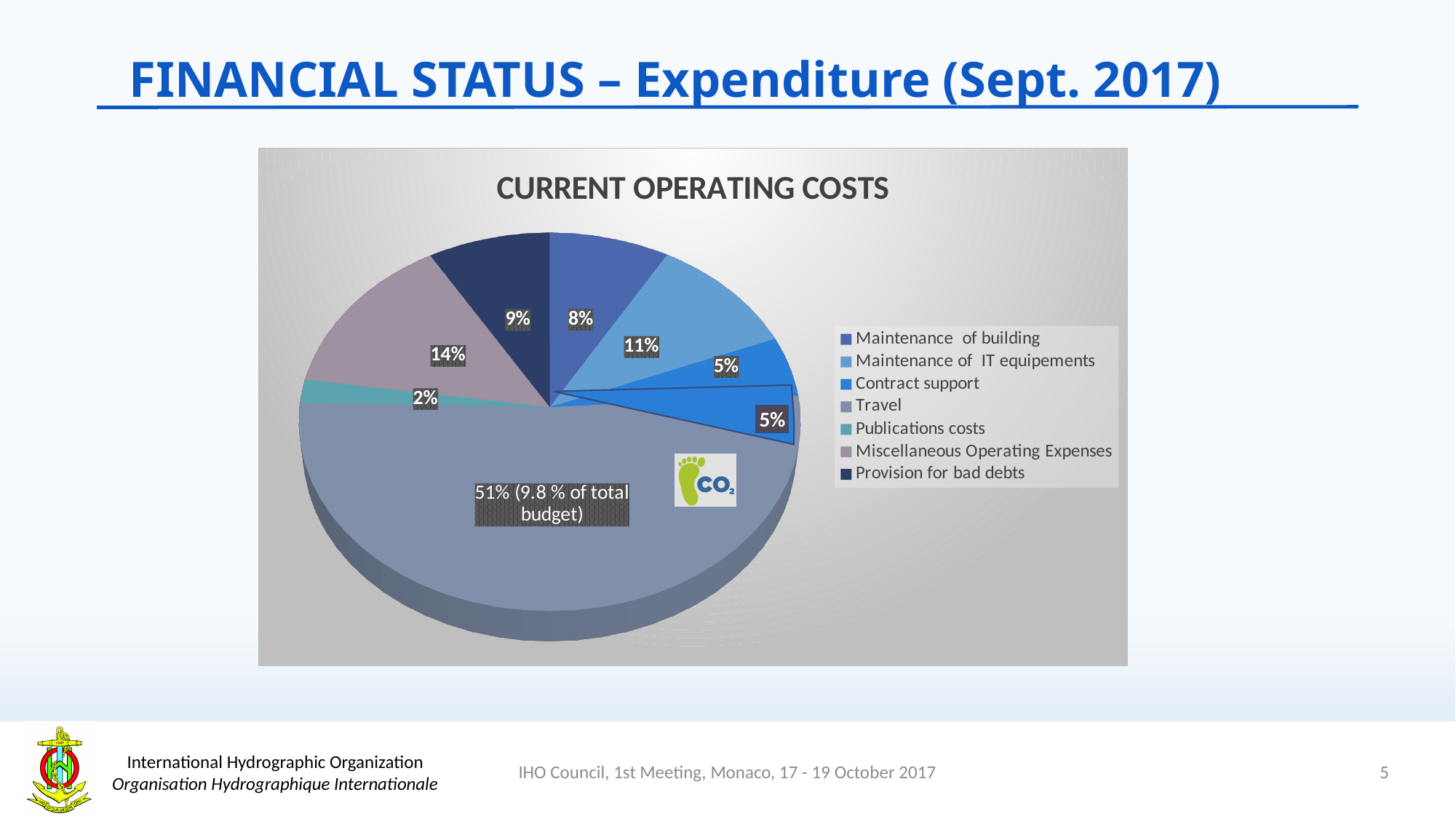
What percentage is shown for Miscellaneous Operating Expenses? 14% What share of current operating costs is Travel? 51% How many entries does the chart's legend list? 7 What percentage is shown for Maintenance of IT equipements? 11% What is the title of the chart? CURRENT OPERATING COSTS What percentage is shown for Publications costs? 2% What percentage is shown for Provision for bad debts? 9% What kind of chart is shown on the slide? pie chart Which is larger, the share for Maintenance of building or the share for Maintenance of IT equipements? Maintenance of IT equipements What is the difference in percentage points between Miscellaneous Operating Expenses and Provision for bad debts? 5 percentage points Which category has the smallest share of the pie? Publications costs Which category has the largest share of the pie? Travel